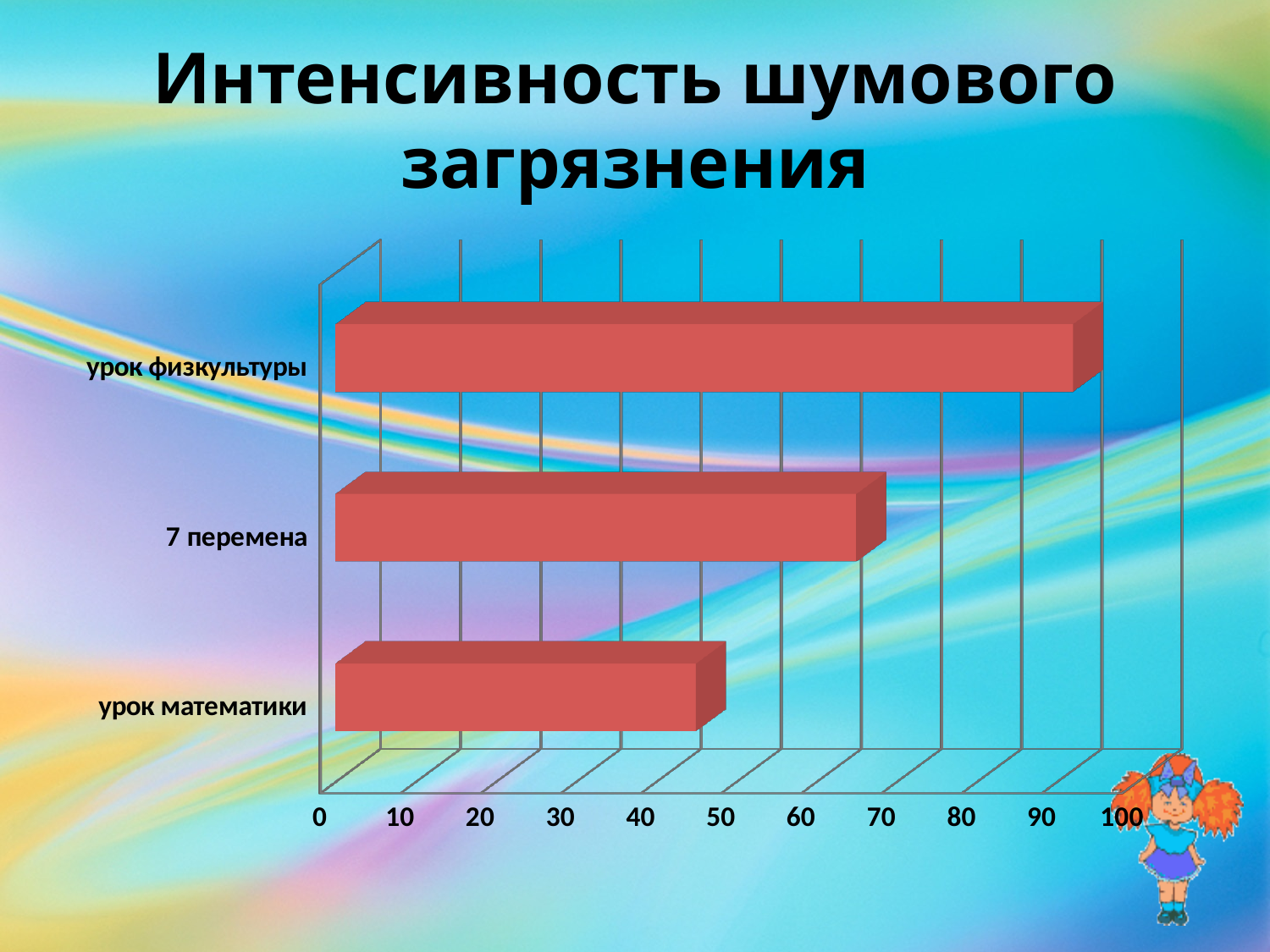
How many categories are plotted in the chart? 3 Which has the larger value: 7 перемена or урок математики? 7 перемена Is the value for 7 перемена greater or less than 60? greater Is the value for урок физкультуры greater or less than 90? greater Which has the larger value: урок физкультуры or 7 перемена? урок физкультуры Is the value for урок математики greater or less than 60? less Which category has the highest value in the chart? урок физкультуры What is the title of the slide's chart? Интенсивность шумового загрязнения What is the maximum value shown on the chart's horizontal axis? 100 Which category has the lowest value in the chart? урок математики What kind of chart is shown on the slide? bar chart